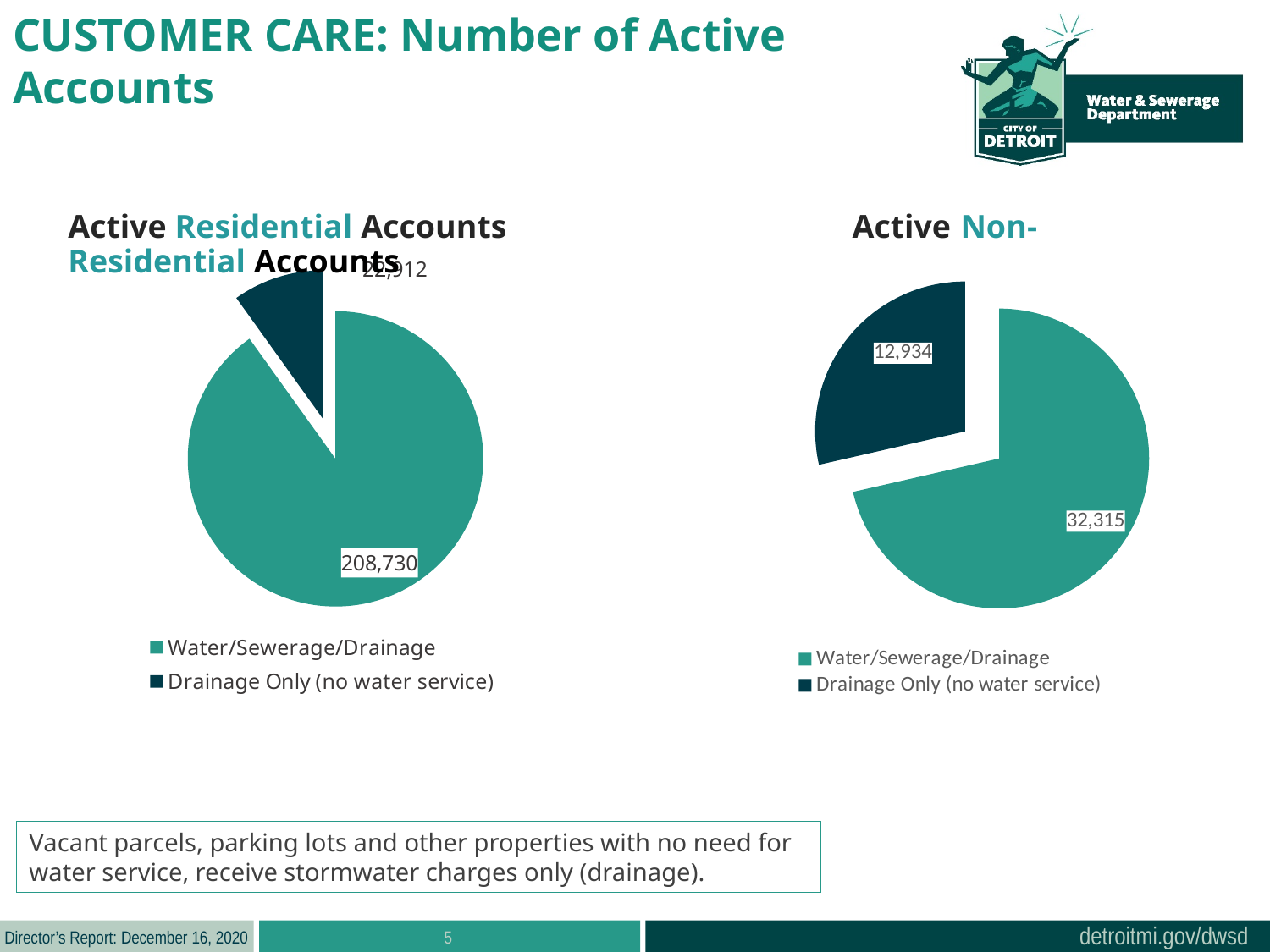
In the Active Residential Accounts pie chart, how many accounts are Water/Sewerage/Drainage? 208,730 In the Active Residential Accounts pie chart, which is larger: Water/Sewerage/Drainage or Drainage Only (no water service)? Water/Sewerage/Drainage How many entries does the legend of the Active Non-Residential Accounts pie chart list? 2 In the Active Residential Accounts pie chart, which category has the smallest slice? Drainage Only (no water service) How many slices does the Active Residential Accounts pie chart have? 2 In the Active Non-Residential Accounts pie chart, how many accounts are Water/Sewerage/Drainage? 32,315 In the Active Non-Residential Accounts pie chart, how many accounts are Drainage Only (no water service)? 12,934 In the Active Non-Residential Accounts pie chart, what colour is the Drainage Only (no water service) slice? Dark teal (dark blue-green) In the Active Non-Residential Accounts pie chart, which category has the largest slice? Water/Sewerage/Drainage What kind of chart is used for the Active Non-Residential Accounts? Pie chart In the Active Non-Residential Accounts pie chart, what is the total number of accounts across both slices? 45,249 In the Active Non-Residential Accounts pie chart, what is the difference between the Water/Sewerage/Drainage and Drainage Only (no water service) values? 19,381